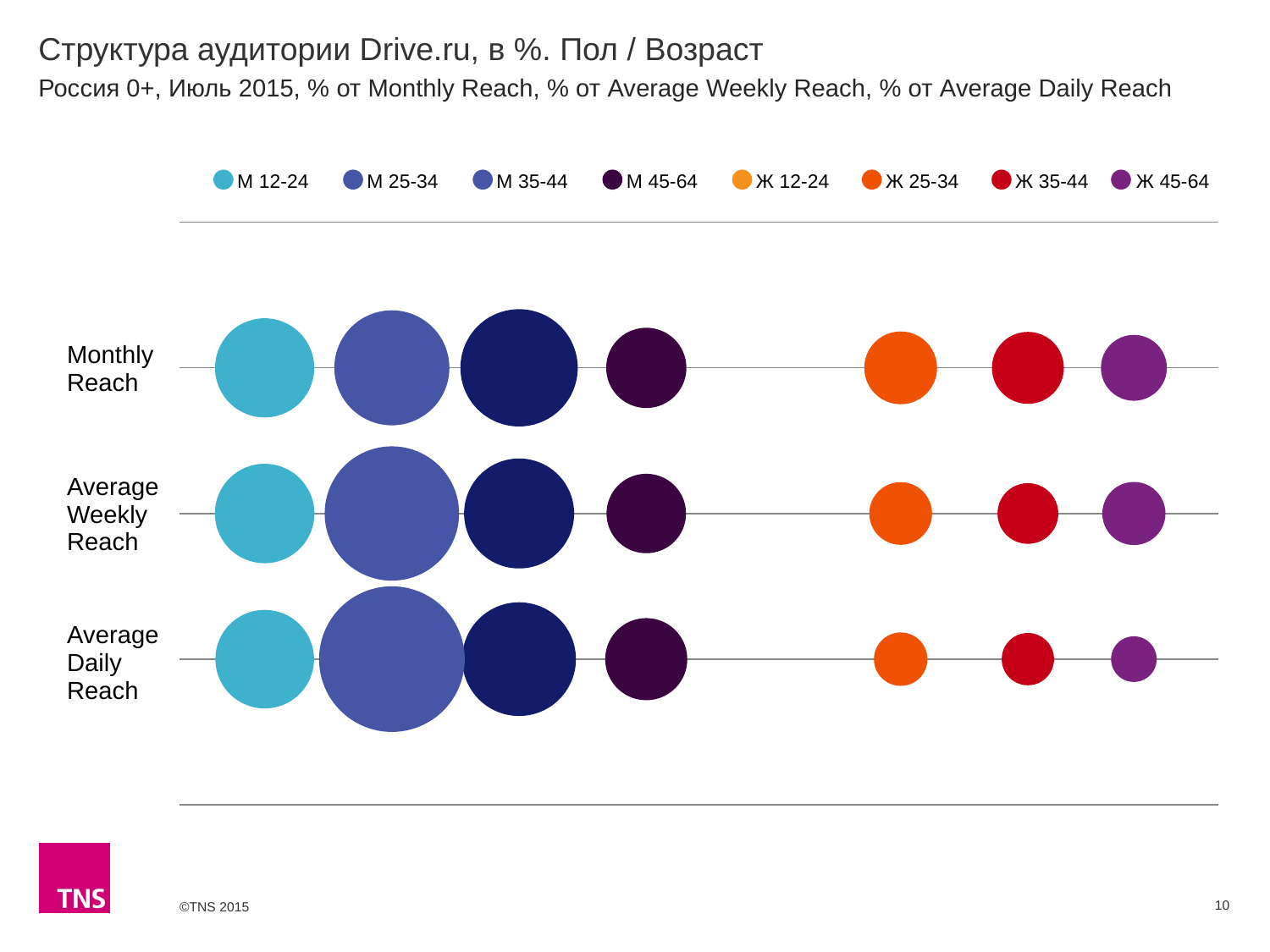
What colour is used for the М 12-24 series in the legend? Light blue Which series has the largest bubble in the Average Daily Reach row? М 25-34 In the Average Weekly Reach row, which bubble is larger: М 25-34 or М 45-64? М 25-34 How many reach categories (rows) are plotted on the chart? 3 Which series has the smallest visible bubble in the Average Daily Reach row? Ж 45-64 Does the bubble for М 25-34 get larger or smaller going from Monthly Reach to Average Daily Reach? Larger What is the title of the chart on the slide? Структура аудитории Drive.ru, в %. Пол / Возраст How many series does the legend list? 8 Does the bubble for Ж 45-64 get larger or smaller going from Monthly Reach to Average Daily Reach? Smaller What kind of chart is shown on the slide? Bubble chart In the Monthly Reach row, which bubble is larger: М 12-24 or Ж 25-34? М 12-24